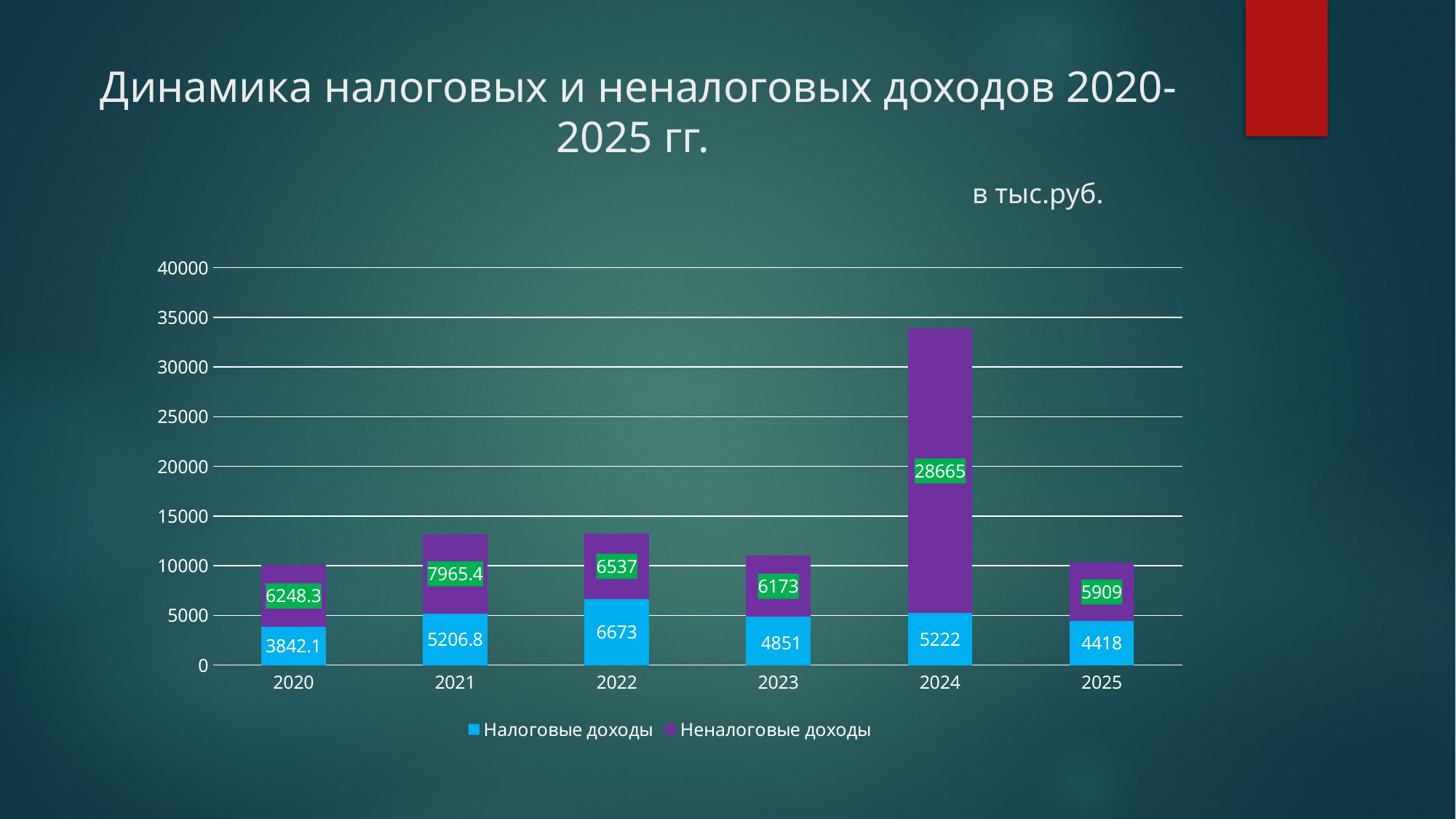
What is the value of Налоговые доходы for 2020? 3842.1 Which is larger: Налоговые доходы in 2021 or Налоговые доходы in 2025? Налоговые доходы in 2021 Which year has the highest value of Неналоговые доходы? 2024 What is the total of the stacked bar for 2023? 11024 What is the value of Неналоговые доходы for 2024? 28665 How many series does the legend list? 2 What is the value of Налоговые доходы for 2022? 6673 How many years are shown on the x axis? 6 What is the total of the stacked bar for 2024? 33887 What kind of chart is shown on the slide? Stacked bar chart What is the difference between Неналоговые доходы in 2024 and in 2023? 22492 Which year has the lowest value of Налоговые доходы? 2020